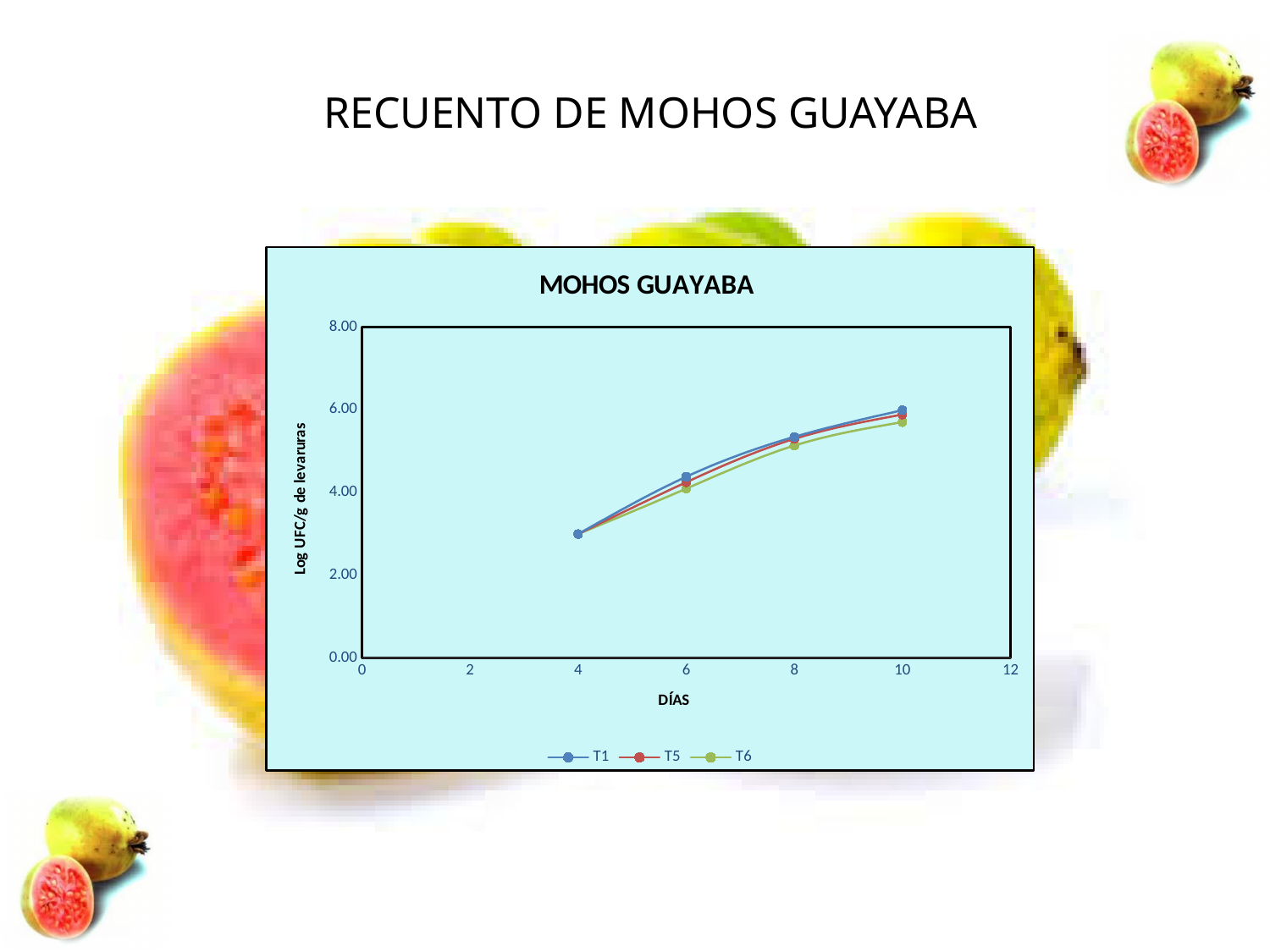
Is the value for T6 at day 8 greater or less than 4.00? greater Do the values for T6 rise or fall along the x axis? rise Is the value for T1 at day 4 greater or less than 4.00? less Is the value for T5 at day 10 greater or less than 4.00? greater What kind of chart is shown on the slide? line chart Do the values for T1 rise or fall as the days increase? rise What are the series names listed in the legend? T1, T5, T6 How many series does the legend list? 3 What is the title of the chart? MOHOS GUAYABA How many data points are plotted for the T1 series? 4